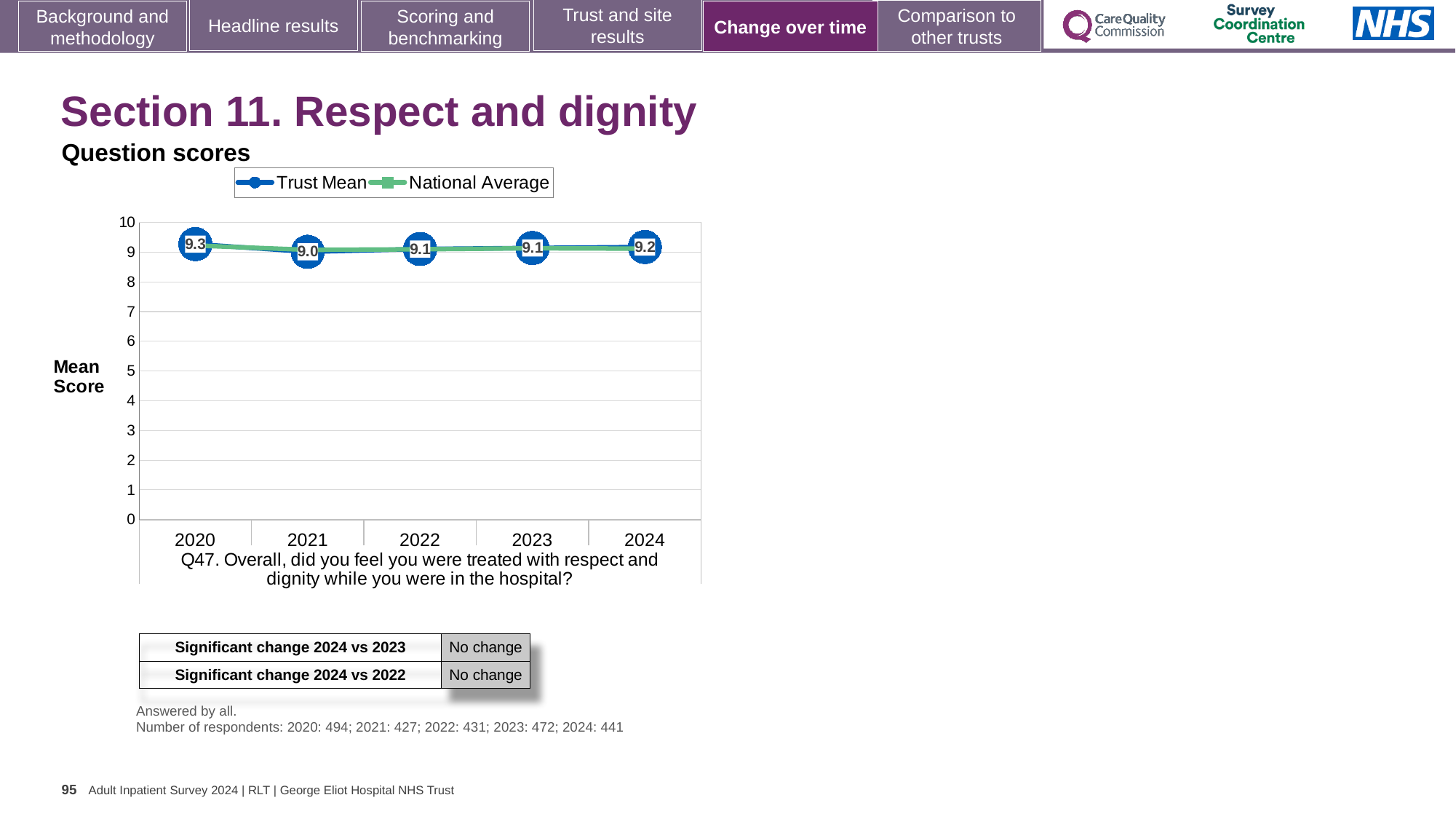
In which year is the Trust Mean score lowest? 2021 How many years are plotted on the x axis? 5 How many series does the legend list? 2 Which year has the larger Trust Mean score, 2021 or 2024? 2024 Does the Trust Mean score rise or fall from 2021 to 2024? Rise What is the difference between the Trust Mean scores for 2020 and 2021? 0.3 Is the National Average value for 2022 greater or less than 8? greater What is the Trust Mean score for 2021? 9.0 In which year is the Trust Mean score highest? 2020 What is the Trust Mean score for 2020? 9.3 What kind of chart is shown? Line chart What is the Trust Mean score for 2024? 9.2